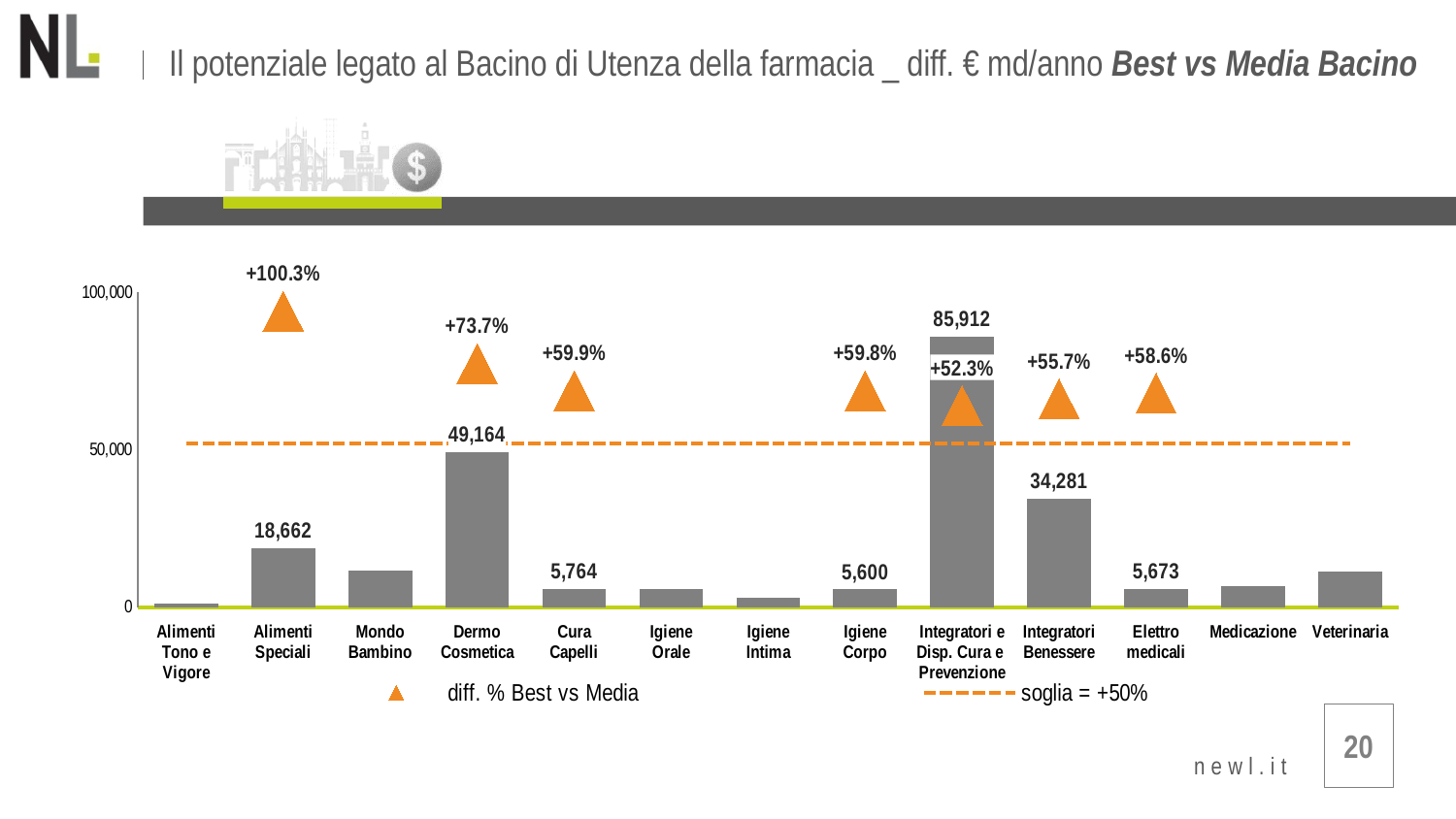
What kind of chart is shown on the slide? combination bar and line chart (bars with a dashed threshold line and triangle markers) What is the diff. % Best vs Media shown for Elettro medicali? +58.6% Which category has the highest bar? Integratori e Disp. Cura e Prevenzione Is the value for Medicazione greater or less than 50,000? less What is the value for Dermo Cosmetica? 49,164 What is the value for Integratori Benessere? 34,281 Which is larger, the value for Cura Capelli or the value for Igiene Corpo? Cura Capelli What is the value for Integratori e Disp. Cura e Prevenzione? 85,912 What threshold does the dashed line represent according to the legend? soglia = +50% What is the diff. % Best vs Media shown for Alimenti Speciali? +100.3% How many categories are shown on the x axis? 13 What is the difference between the values for Integratori e Disp. Cura e Prevenzione and Dermo Cosmetica? 36,748